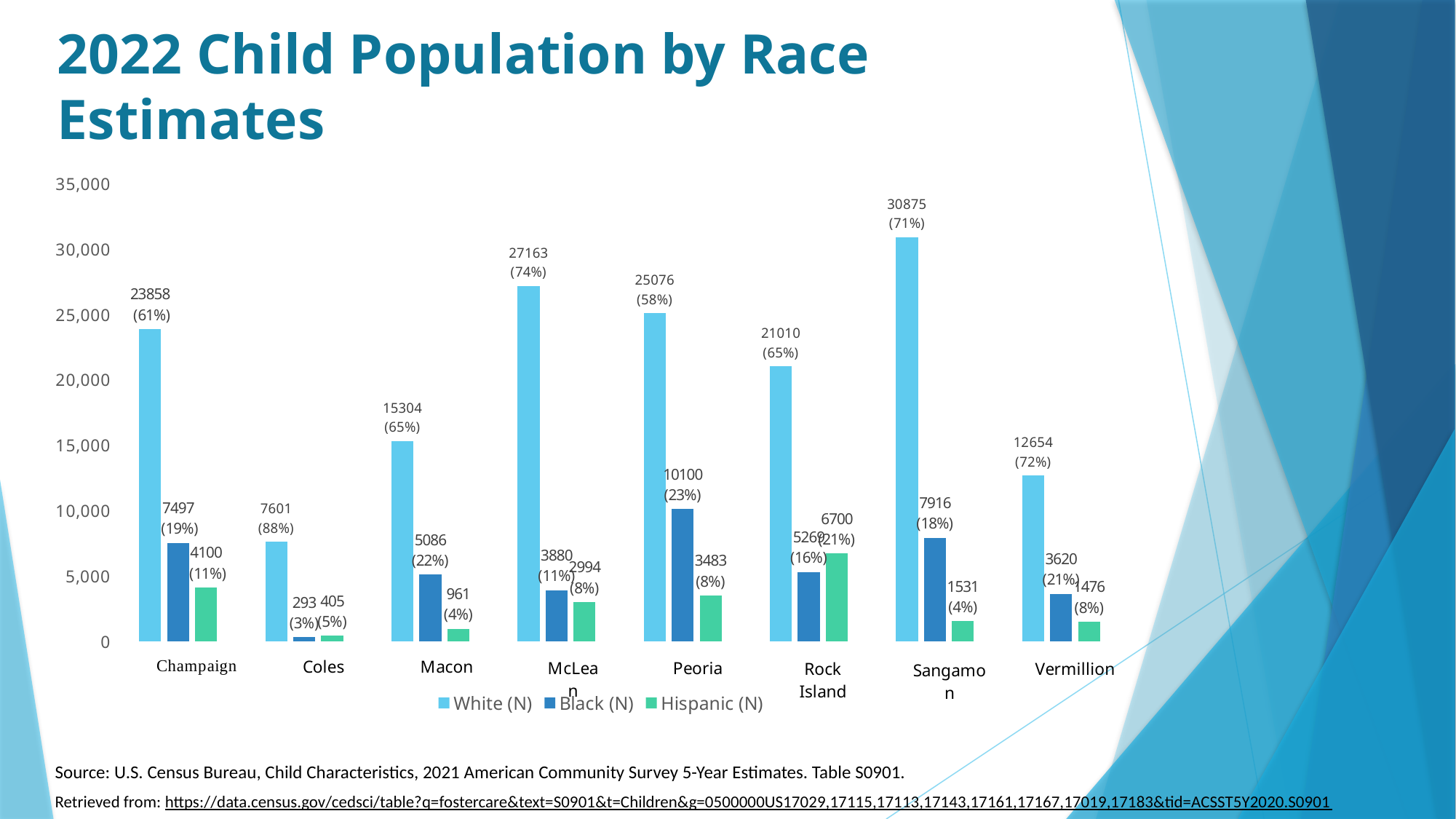
What is the White (N) value for Champaign? 23858 Which county has the lowest Black (N) value? Coles How many counties are shown on the x axis? 8 How many series does the legend list? 3 Which is larger, the Hispanic (N) value for Rock Island or for Champaign? Rock Island Which county has the highest White (N) value? Sangamon Is the White (N) value for Vermillion greater or less than 10,000? greater What is the difference between the White (N) values for Sangamon and McLean? 3712 What kind of chart is shown on the slide? bar chart What percentage is shown next to the White (N) bar for Coles? 88% What is the total of the three values shown for Coles? 8299 What is the Black (N) value for Peoria? 10100